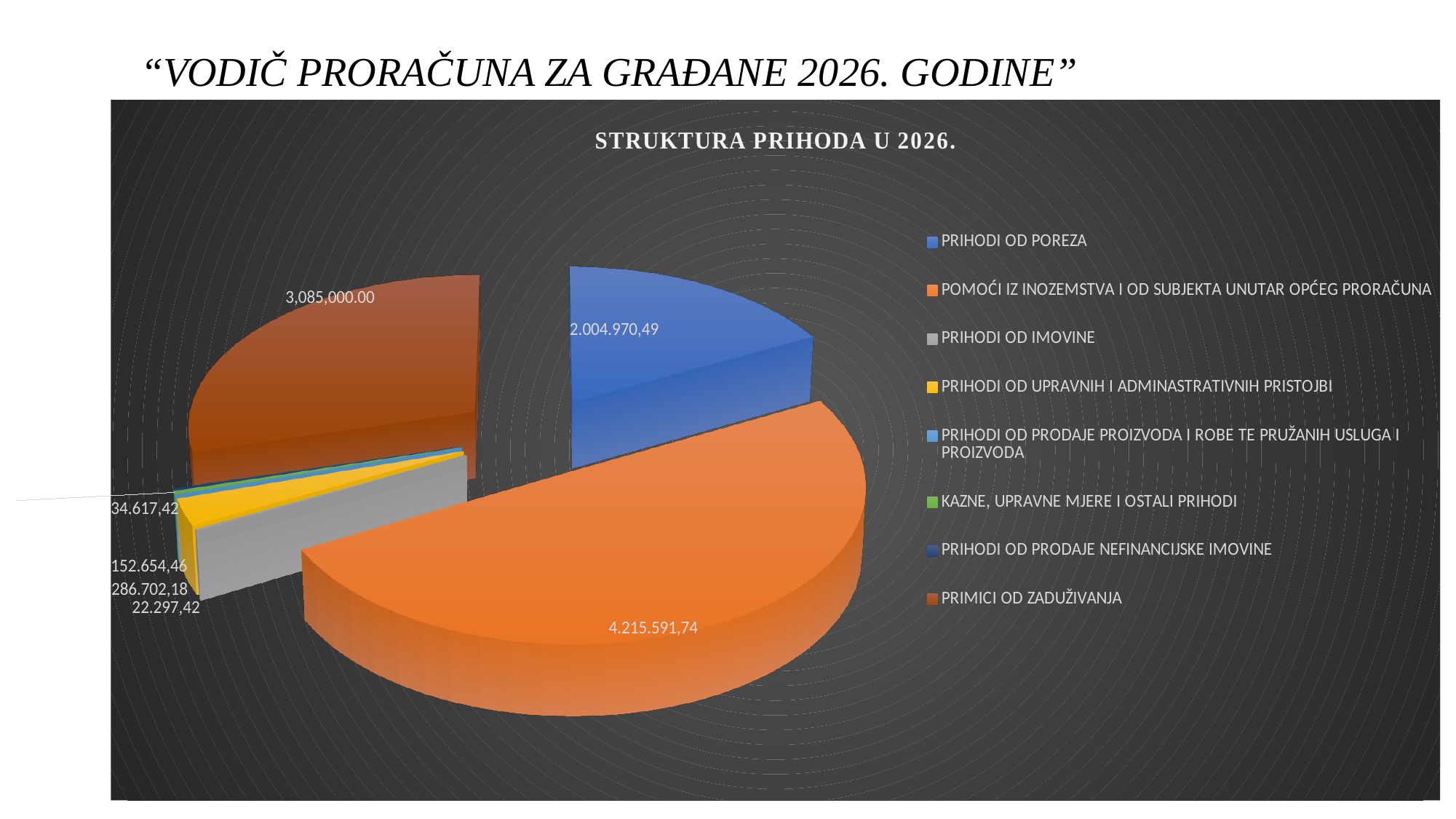
What is the difference between the value for POMOĆI IZ INOZEMSTVA I OD SUBJEKTA UNUTAR OPĆEG PRORAČUNA and the value for PRIHODI OD POREZA? 2.210.621,25 How many categories does the legend of the pie chart list? 8 What is the title of the chart? STRUKTURA PRIHODA U 2026. What is the value shown for PRIHODI OD POREZA? 2.004.970,49 Which is larger, PRIHODI OD POREZA or PRIMICI OD ZADUŽIVANJA? PRIMICI OD ZADUŽIVANJA What kind of chart is shown on the slide? pie chart What is the value shown for PRIMICI OD ZADUŽIVANJA? 3,085,000.00 What colour is the slice for PRIHODI OD POREZA? blue Which category has the largest slice of the pie? POMOĆI IZ INOZEMSTVA I OD SUBJEKTA UNUTAR OPĆEG PRORAČUNA What is the difference between the value for PRIMICI OD ZADUŽIVANJA and the value for PRIHODI OD POREZA? 1.080.029,51 What is the value shown for POMOĆI IZ INOZEMSTVA I OD SUBJEKTA UNUTAR OPĆEG PRORAČUNA? 4.215.591,74 Which is larger, POMOĆI IZ INOZEMSTVA I OD SUBJEKTA UNUTAR OPĆEG PRORAČUNA or PRIMICI OD ZADUŽIVANJA? POMOĆI IZ INOZEMSTVA I OD SUBJEKTA UNUTAR OPĆEG PRORAČUNA